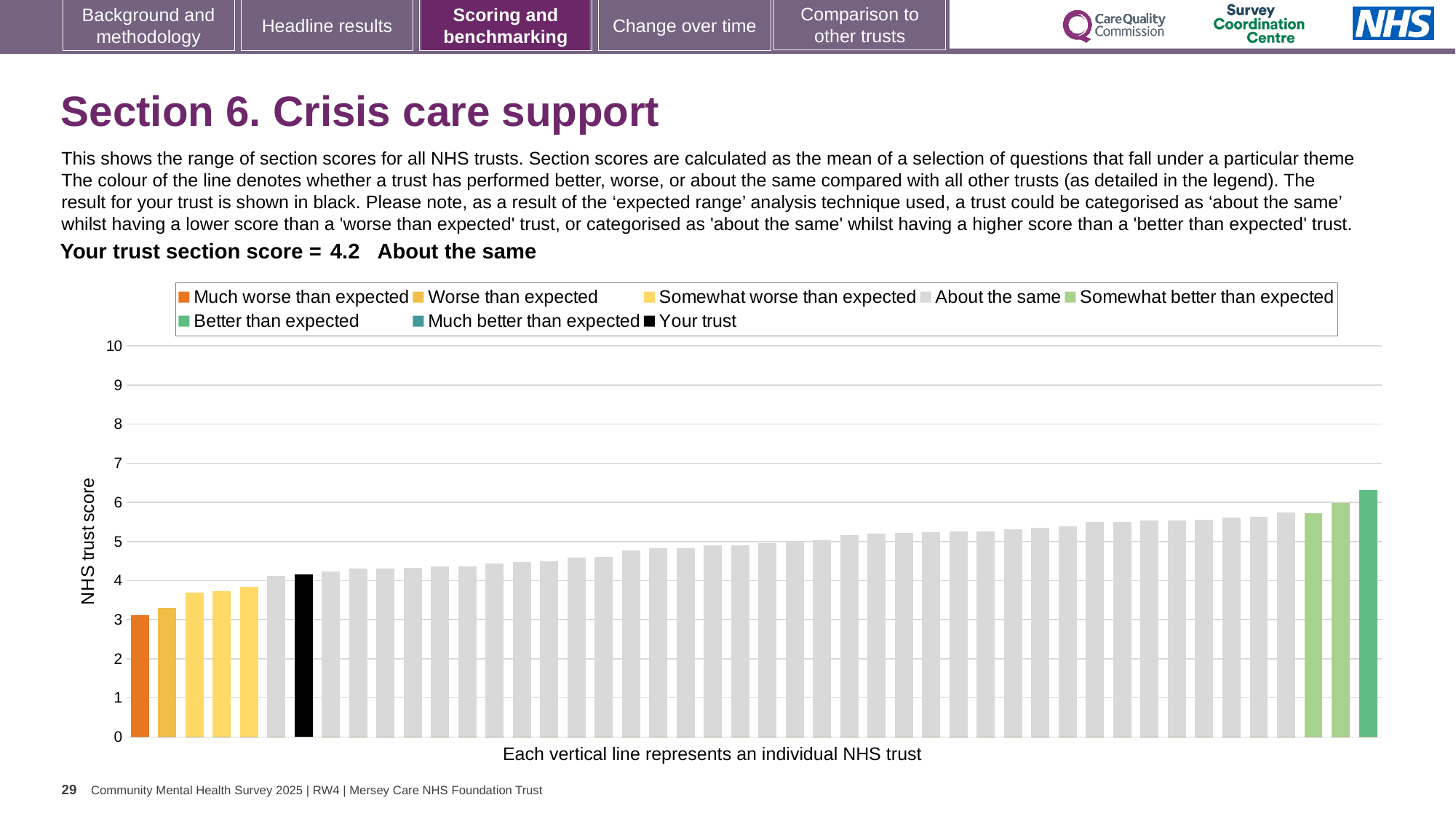
Which legend category does the shortest bar belong to? Much worse than expected Which legend category does the tallest bar belong to? Better than expected Which is taller, the 'Your trust' bar or the 'Much worse than expected' bar? Your trust What is the section score for your trust (the black bar)? 4.2 How many entries does the chart legend list? 8 Do the bar values rise or fall from left to right along the x axis? Rise How many bars are coloured as 'Somewhat worse than expected'? 3 Is the value of the shortest bar greater or less than 4? less What kind of chart is shown on the slide? Bar chart Is the value of the tallest bar greater or less than 6? greater What is the label on the y axis of the chart? NHS trust score Is the value of the black 'Your trust' bar greater or less than 4? greater